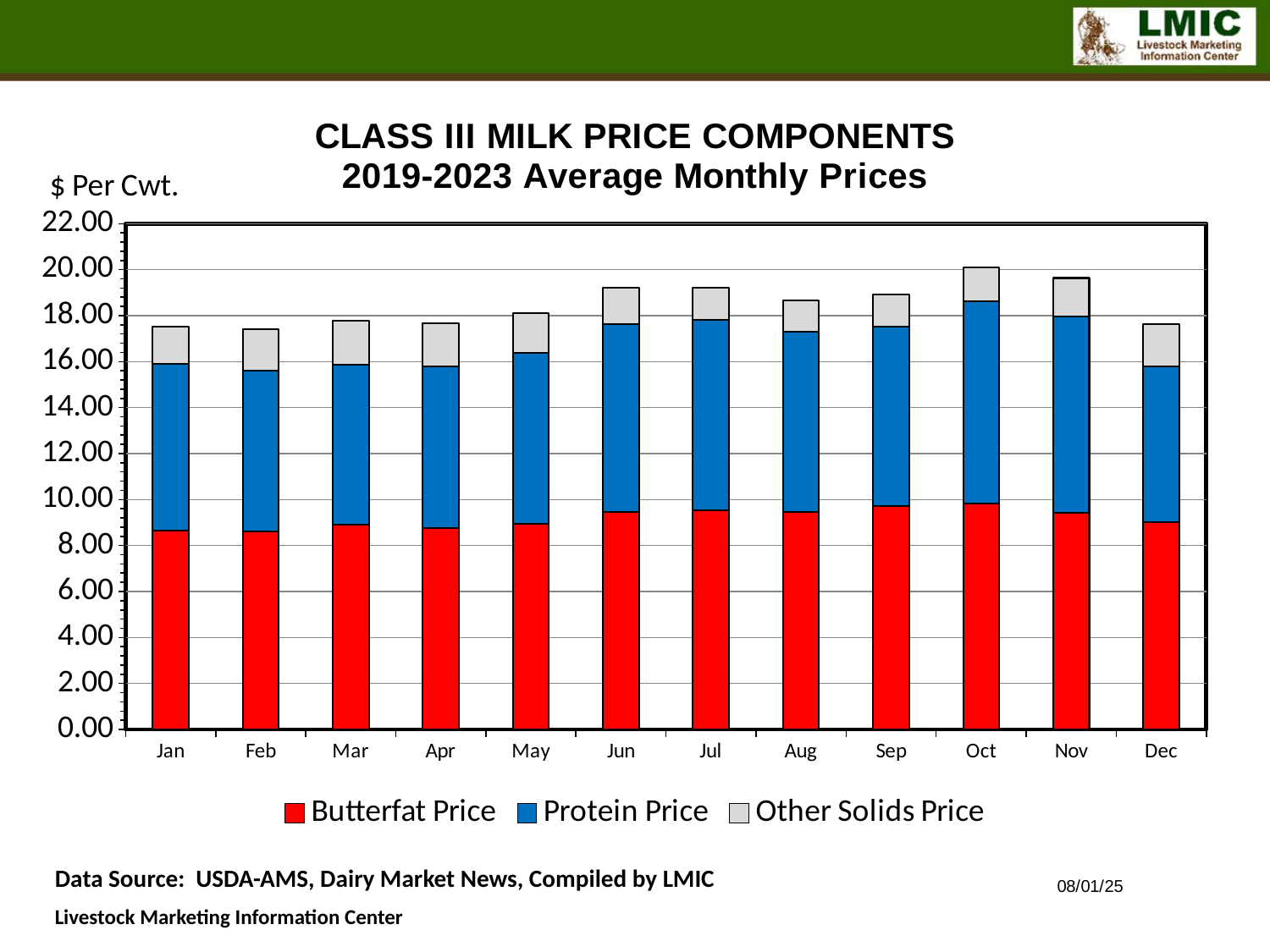
Which colour represents the Butterfat Price series? Red Is the Butterfat Price for Jan greater or less than 10.00? less Is the total bar for Jun greater or less than 18.00? greater Which is larger, the total bar for Oct or the total bar for Feb? Oct How many series does the legend list? 3 Is the Butterfat Price for Jan greater or less than 8.00? greater What kind of chart is shown on the slide? Stacked bar chart Do the total bars rise or fall from Oct to Dec? fall What unit is shown on the y axis label? $ Per Cwt. How many months (categories) are shown on the x axis? 12 Which month has the highest total Class III milk price? Oct